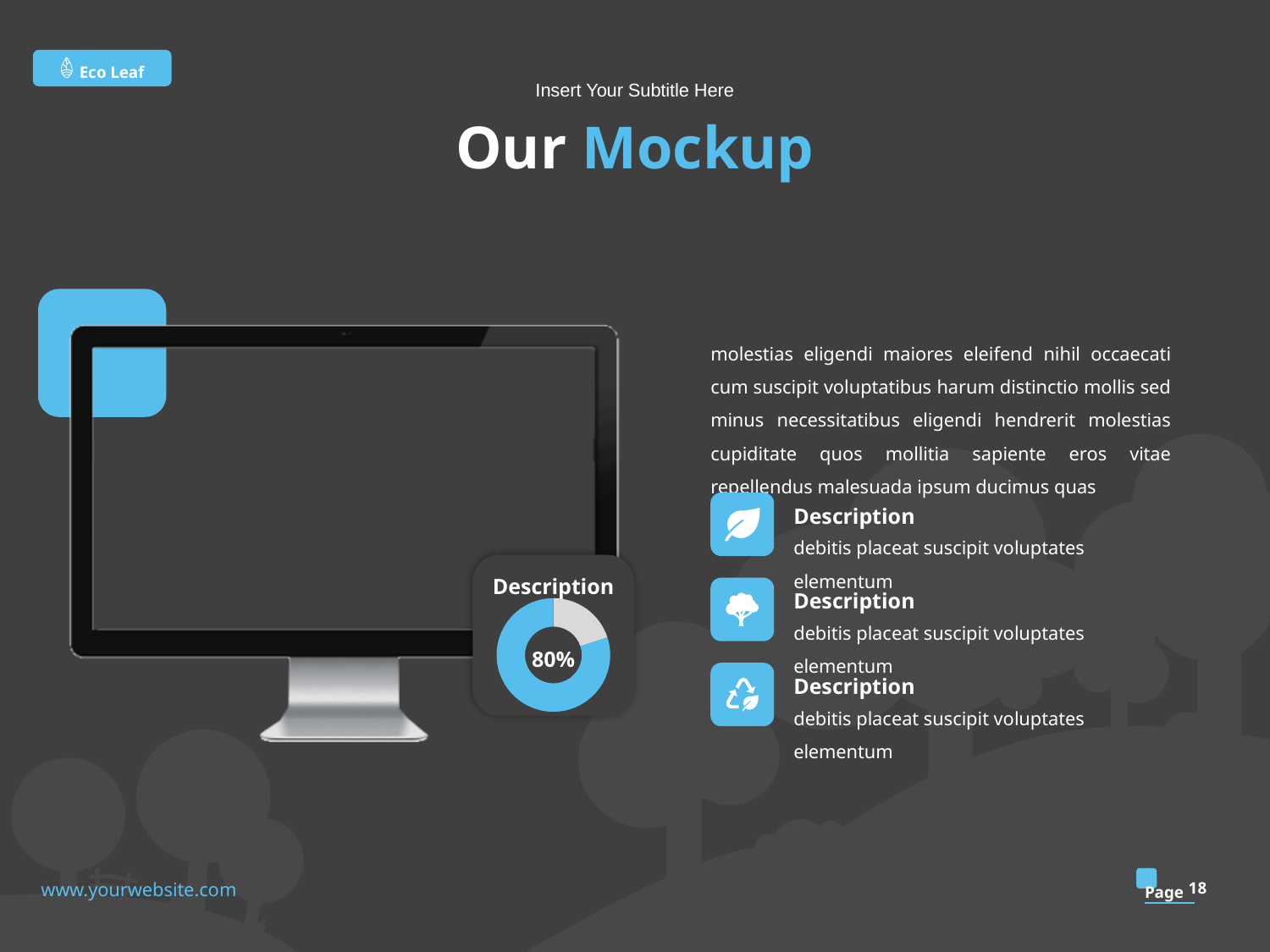
What value is printed in the centre of the doughnut chart? 80% What colour is the largest slice of the doughnut chart? blue What share of the doughnut chart does the blue slice represent? 80% How many slices does the doughnut chart have? 2 What is the title of the doughnut chart? Description Which slice of the doughnut chart is larger, the blue one or the grey one? blue What kind of chart is shown on the slide? doughnut chart